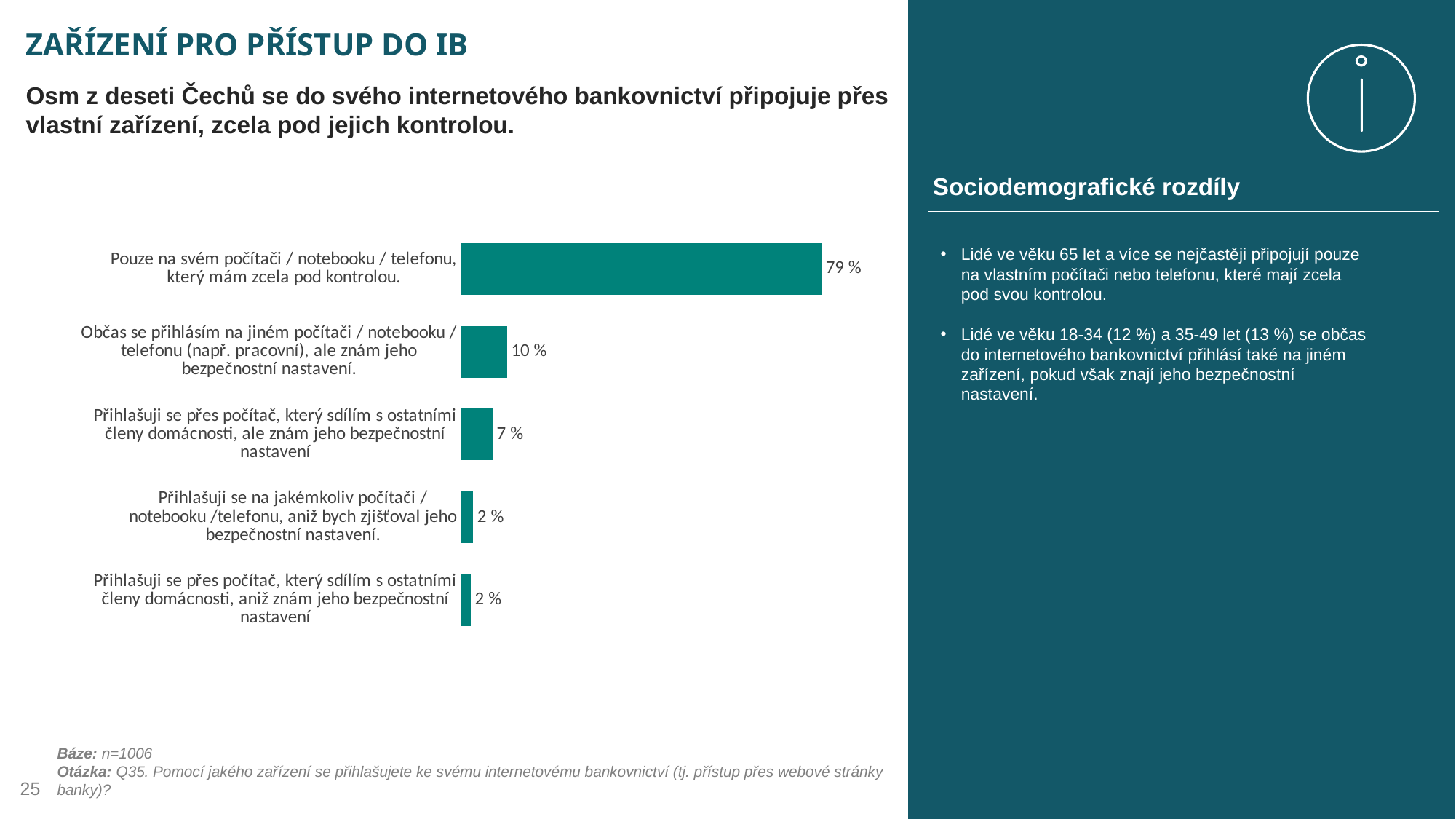
What is the base (n) stated for the chart? n=1006 What value is shown for 'Občas se přihlásím na jiném počítači / notebooku / telefonu (např. pracovní), ale znám jeho bezpečnostní nastavení.'? 10 % What kind of chart is shown on the slide? Bar chart What is the difference between the value for 'Pouze na svém počítači / notebooku / telefonu, který mám zcela pod kontrolou.' and the value for 'Občas se přihlásím na jiném počítači / notebooku / telefonu (např. pracovní), ale znám jeho bezpečnostní nastavení.'? 69 % Which category has the highest value in the chart? Pouze na svém počítači / notebooku / telefonu, který mám zcela pod kontrolou. What value is shown for the category 'Pouze na svém počítači / notebooku / telefonu, který mám zcela pod kontrolou.'? 79 % What value is shown for 'Přihlašuji se na jakémkoliv počítači / notebooku /telefonu, aniž bych zjišťoval jeho bezpečnostní nastavení.'? 2 % How many categories are shown in the chart? 5 Which is larger: the value for 'Občas se přihlásím na jiném počítači / notebooku / telefonu (např. pracovní), ale znám jeho bezpečnostní nastavení.' or the value for 'Přihlašuji se přes počítač, který sdílím s ostatními členy domácnosti, ale znám jeho bezpečnostní nastavení'? Občas se přihlásím na jiném počítači / notebooku / telefonu (např. pracovní), ale znám jeho bezpečnostní nastavení. How many categories in the chart have a value of 2 %? 2 What value is shown for 'Přihlašuji se přes počítač, který sdílím s ostatními členy domácnosti, ale znám jeho bezpečnostní nastavení'? 7 % What is the difference between the value for 'Občas se přihlásím na jiném počítači / notebooku / telefonu (např. pracovní), ale znám jeho bezpečnostní nastavení.' and the value for 'Přihlašuji se přes počítač, který sdílím s ostatními členy domácnosti, ale znám jeho bezpečnostní nastavení'? 3 %